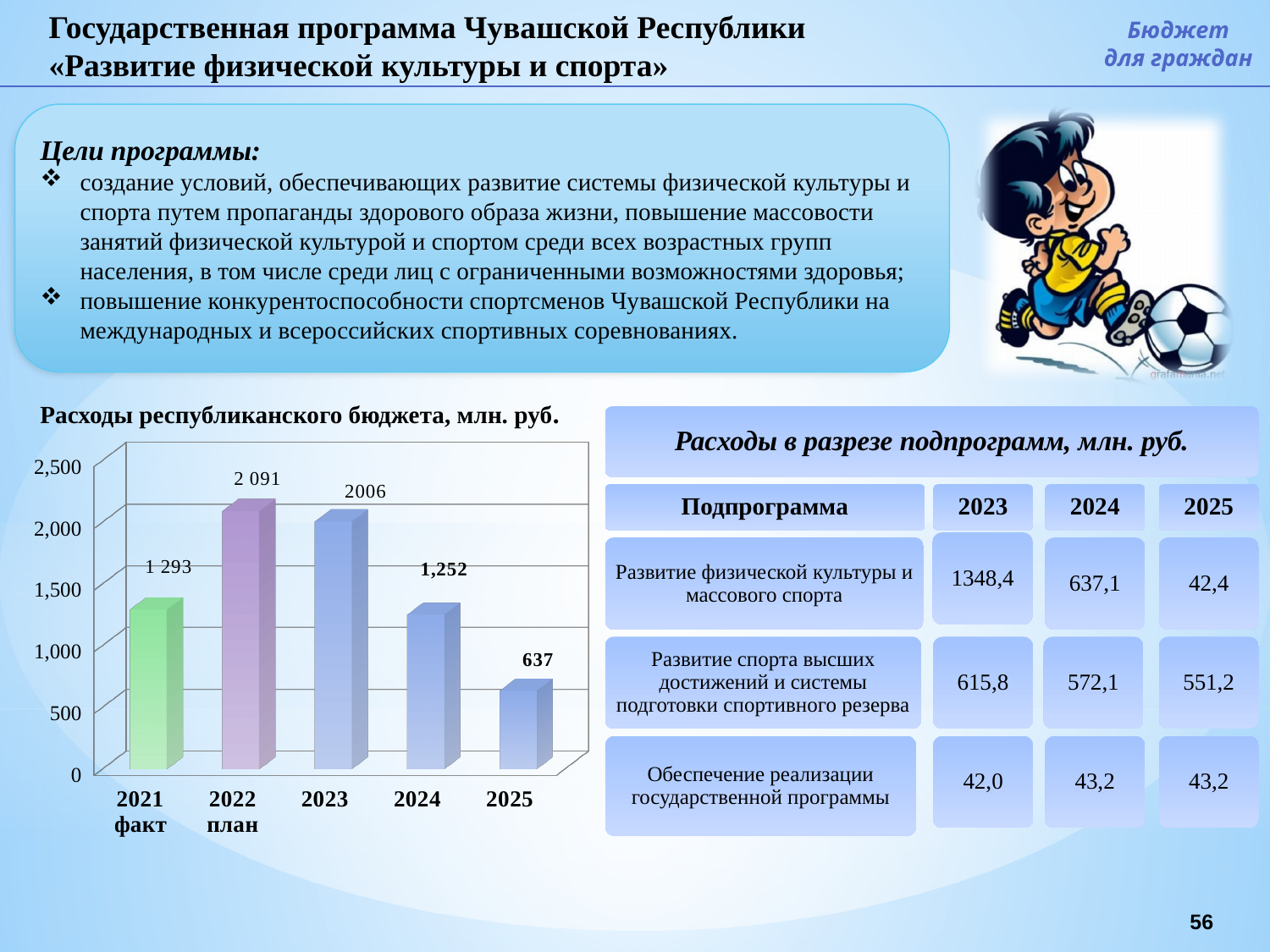
What is the value for 2023 in the chart? 2006 What is the value for 2022 план in the chart? 2 091 What is the value for 2021 факт in the chart 'Расходы республиканского бюджета, млн. руб.'? 1 293 How many years are shown on the x axis of the chart? 5 What kind of chart is 'Расходы республиканского бюджета, млн. руб.'? bar chart Which year has the lowest value in the chart? 2025 Is the value for 2024 greater or less than 1,500? less Which year has the highest value in the chart? 2022 What is the difference between the values for 2024 and 2025 in the chart? 615 Which is larger in the chart, the value for 2023 or the value for 2024? 2023 What is the difference between the values for 2022 and 2021 in the chart? 798 What is the value for 2025 in the chart? 637